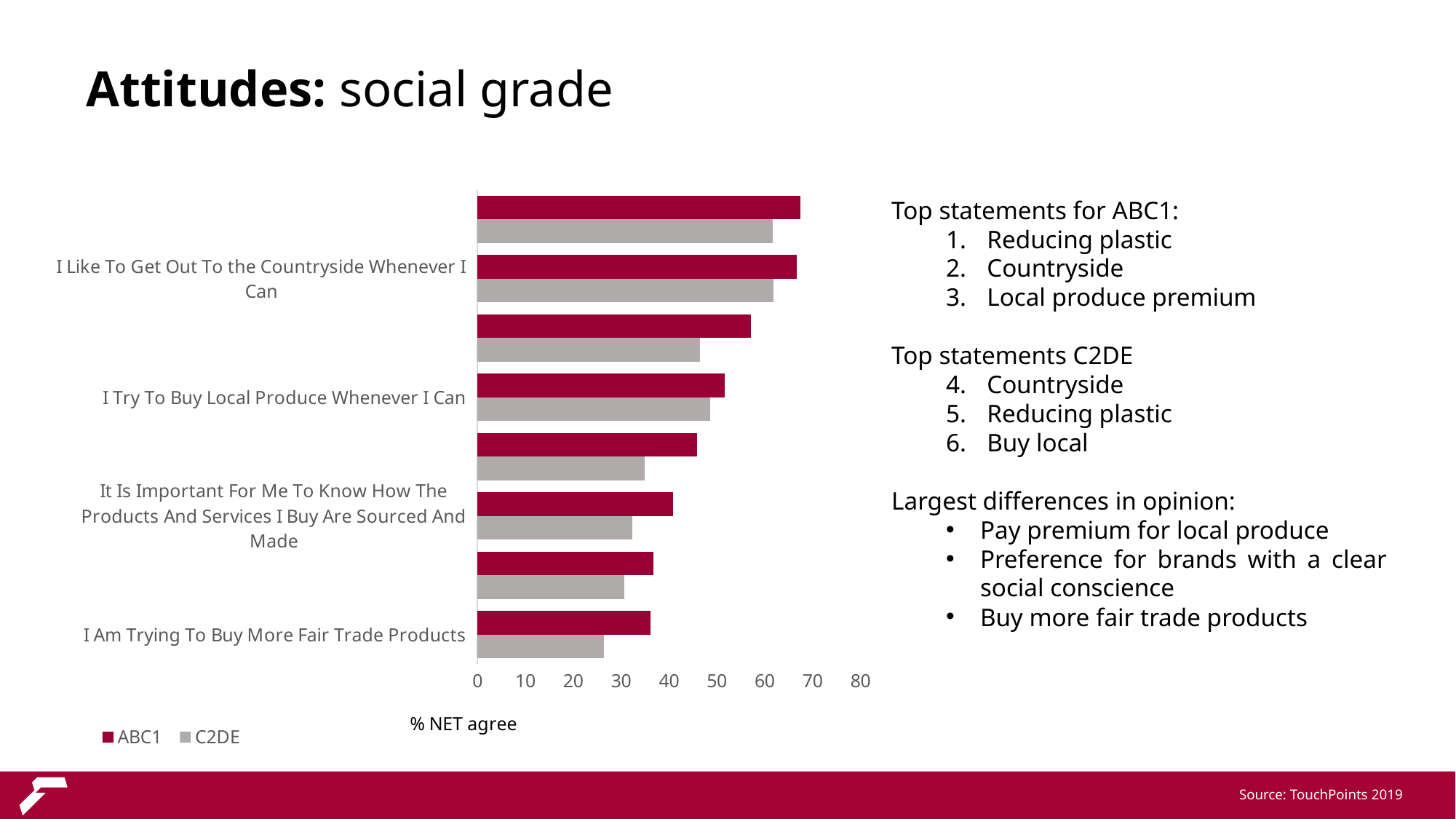
What kind of chart is shown on the slide? bar chart Is the C2DE value for 'I Am Trying To Buy More Fair Trade Products' greater or less than 30? less Is the ABC1 value for 'It Is Important For Me To Know How The Products And Services I Buy Are Sourced And Made' greater or less than 50? less Of the labelled statements on the chart, which has the highest ABC1 value? I Like To Get Out To the Countryside Whenever I Can What are the two series named in the chart legend? ABC1 and C2DE What is the label shown beneath the chart's horizontal axis? % NET agree For 'I Am Trying To Buy More Fair Trade Products', which series has the larger value, ABC1 or C2DE? ABC1 Is the C2DE value for 'I Try To Buy Local Produce Whenever I Can' greater or less than 40? greater Of the labelled statements on the chart, which has the lowest C2DE value? I Am Trying To Buy More Fair Trade Products For 'It Is Important For Me To Know How The Products And Services I Buy Are Sourced And Made', which series has the larger value, ABC1 or C2DE? ABC1 How many series does the chart legend list? 2